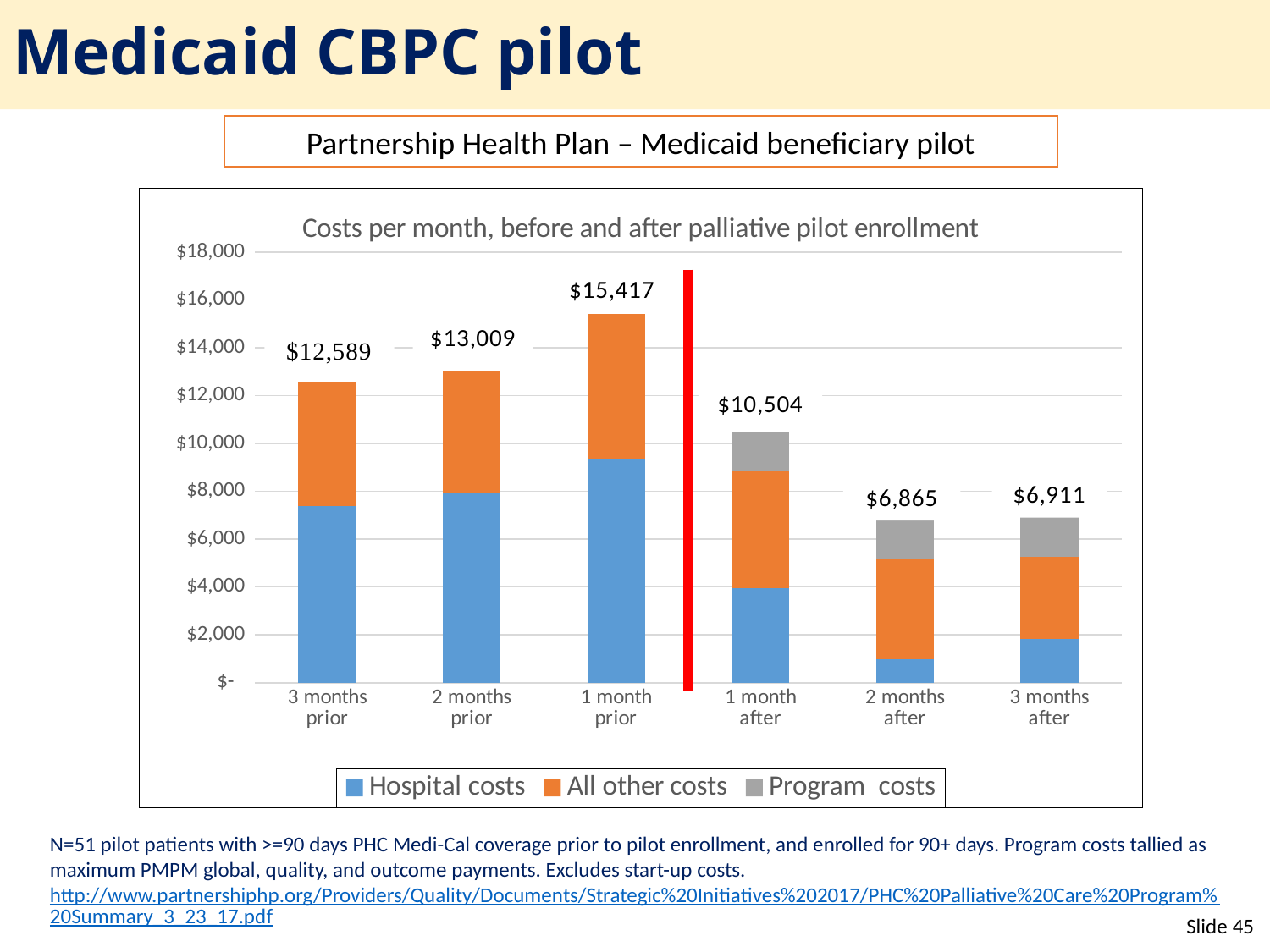
Which month has the highest total cost per month? 1 month prior Which month has the lowest total cost per month? 2 months after Is the Hospital costs value for 1 month prior to enrollment greater or less than $8,000? greater What is the total cost per month labeled for 1 month prior to enrollment? $15,417 What is the total cost per month labeled for 2 months after enrollment? $6,865 Which is larger, the total cost for 2 months prior or the total cost for 3 months after? 2 months prior What is the difference between the total cost for 1 month prior and the total cost for 1 month after enrollment? $4,913 What is the total cost per month labeled for 3 months prior to enrollment? $12,589 Is the Hospital costs value for 2 months after enrollment greater or less than $2,000? less How many series does the legend list? 3 How many months (categories) are shown on the x axis? 6 What kind of chart is shown on the slide? Stacked bar chart